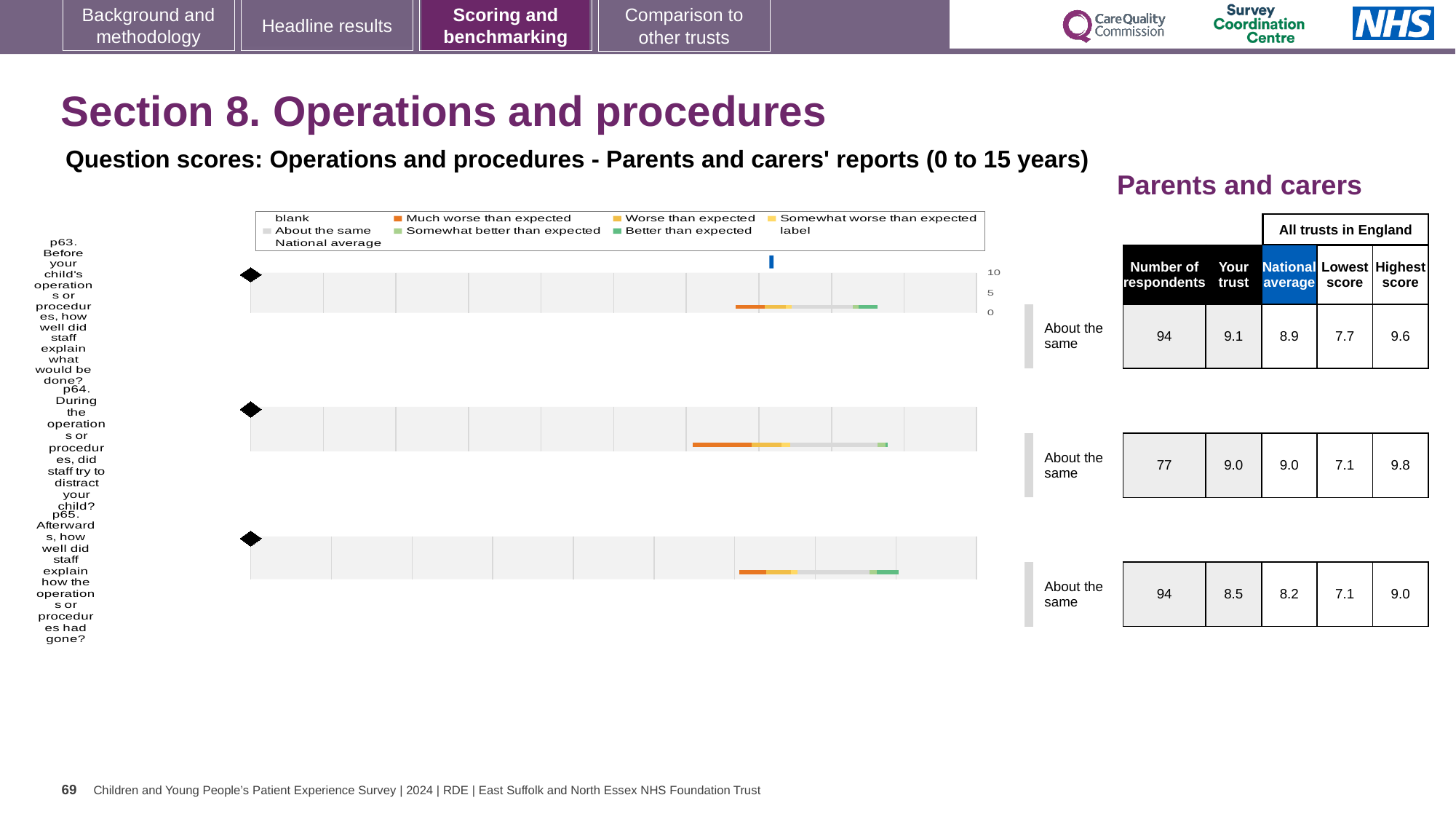
For p63, which is larger: the 'Your trust' score or the national average? Your trust How many respondents answered p64? 77 How many questions (p63, p64, p65) are plotted on the slide? 3 Which question has the highest 'Your trust' score? p63 What benchmark category is shown for all three questions on the slide? About the same What is the national average score for p64 (did staff try to distract your child)? 9.0 Which question has the lowest 'Your trust' score? p65 What is the highest score among all trusts in England for p64? 9.8 What kind of chart is used to show the question scores on this slide? bar chart What is the lowest score among all trusts in England for p63? 7.7 For p65, what is the difference between the 'Your trust' score and the national average? 0.3 What is the 'Your trust' score for p63 (how well staff explained what would be done before the operation)? 9.1